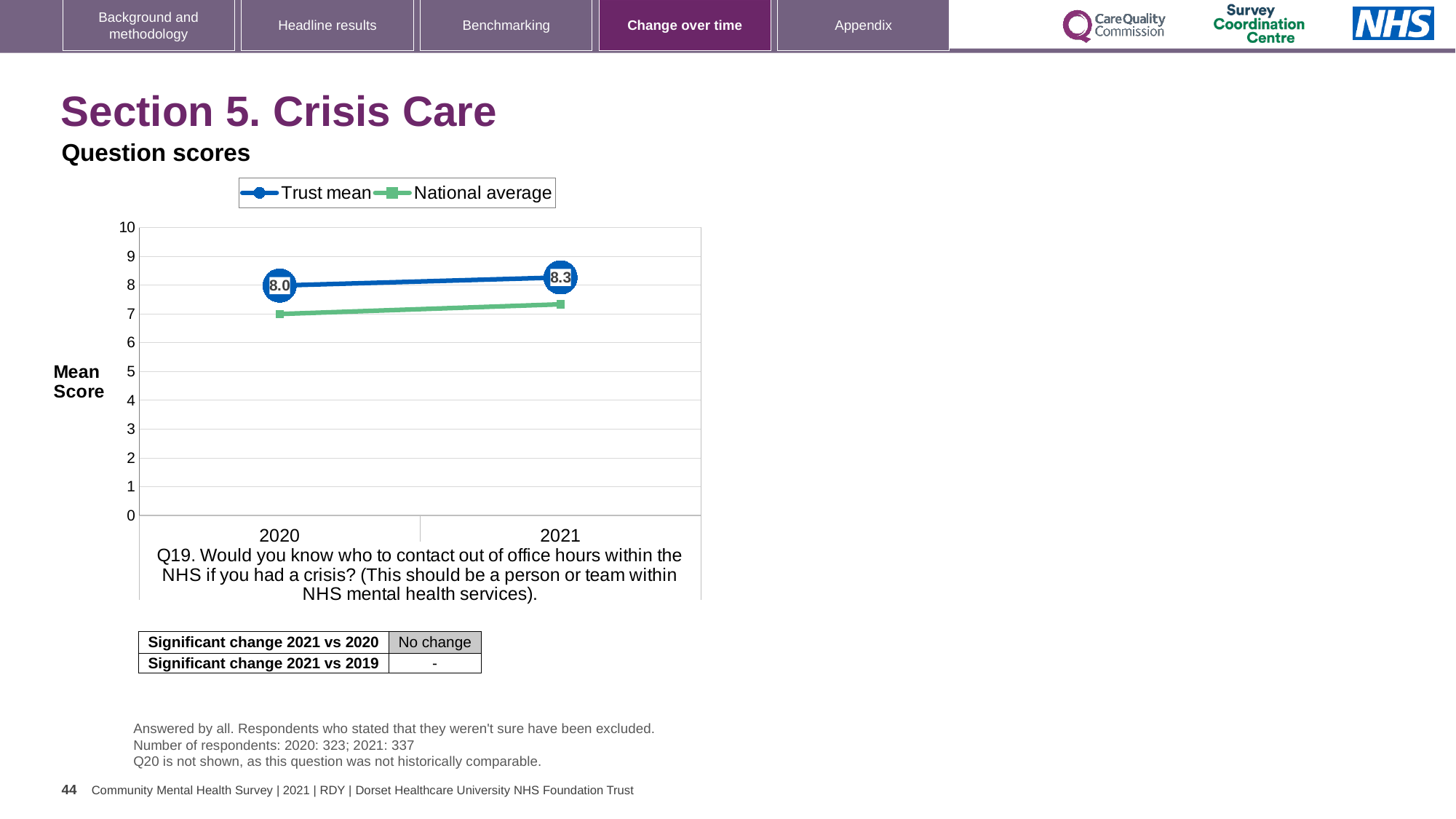
How many series does the legend list? 2 What is the Trust mean score for 2021? 8.3 What is the Trust mean score for 2020? 8.0 In 2021, which is larger: the Trust mean or the National average? Trust mean How many years are plotted on the x axis? 2 Does the Trust mean rise or fall from 2020 to 2021? rise Is the National average for 2020 greater or less than 8? less What kind of chart is shown on the slide? line chart Is the National average for 2021 greater or less than 7? greater Which year has the lower Trust mean score? 2020 Which year has the higher Trust mean score? 2021 What is the difference between the Trust mean scores for 2021 and 2020? 0.3